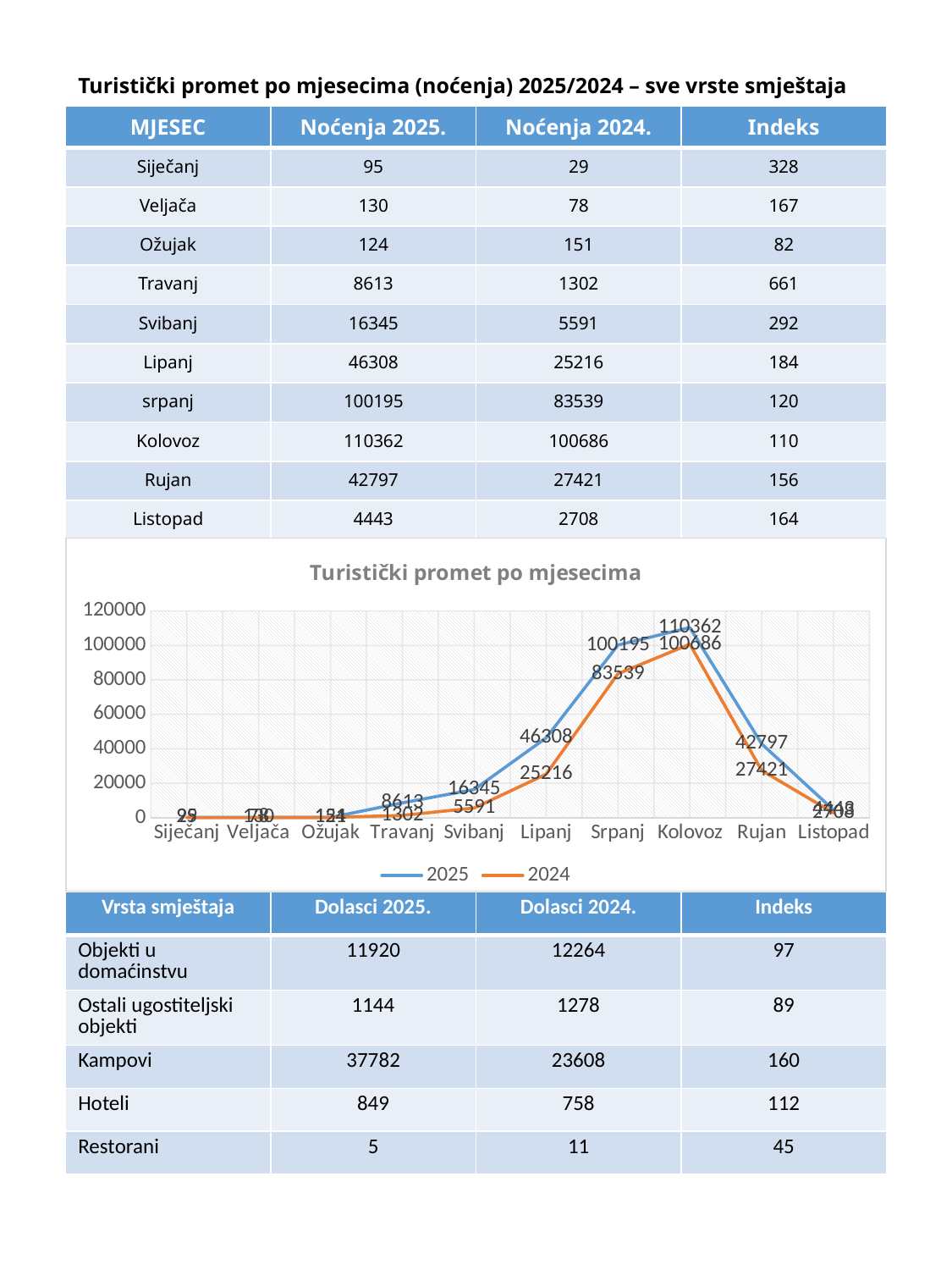
Which is larger in Svibanj, the 2025 value or the 2024 value? 2025 What is the value for 2025 in Lipanj on the chart? 46308 What is the value for 2025 in Kolovoz on the chart? 110362 Which month has the highest value for the 2025 series? Kolovoz What is the difference between the 2025 and 2024 values in Srpanj? 16656 What is the value for 2024 in Rujan on the chart? 27421 How many series does the chart legend list? 2 What kind of chart is shown on the slide? line chart What is the title of the chart? Turistički promet po mjesecima Is the 2025 value for Rujan greater or less than 40000? greater How many months are plotted along the x axis of the chart? 10 What is the value for 2024 in Srpanj on the chart? 83539